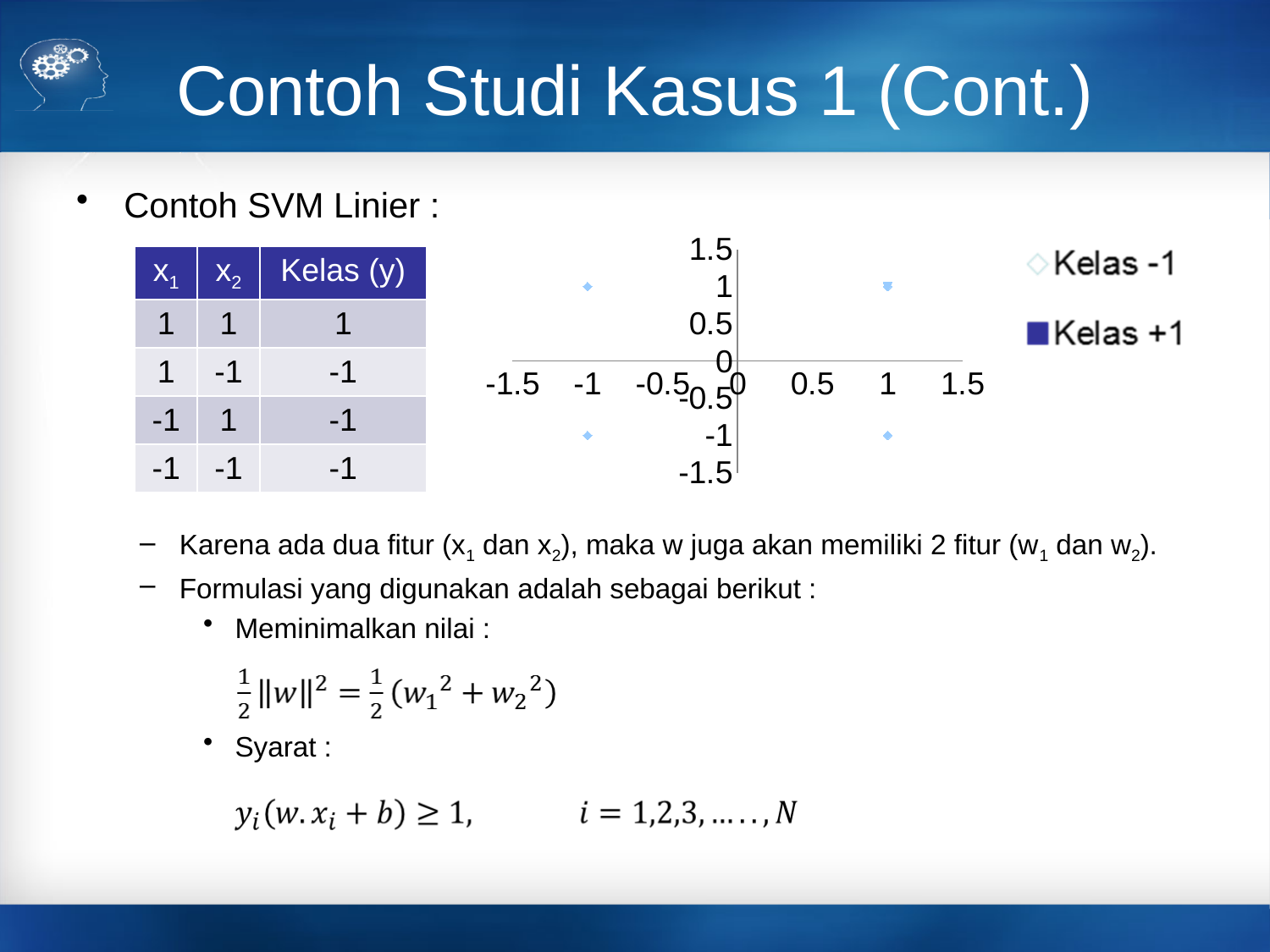
What are the two series named in the chart legend? Kelas -1 and Kelas +1 How many points belong to the Kelas +1 series? 1 How many data points are plotted on the chart? 4 What kind of chart is shown on the slide? scatter chart How many points belong to the Kelas -1 series? 3 What is the minimum value shown on the vertical axis of the chart? -1.5 What are the coordinates of the Kelas +1 point on the chart? (1, 1) Is the horizontal-axis value of the Kelas -1 point in the lower-left quadrant greater or less than -0.5? less What is the maximum value shown on the horizontal axis of the chart? 1.5 Is the vertical-axis value of the Kelas +1 point greater or less than 0.5? greater Which series has more points plotted, Kelas -1 or Kelas +1? Kelas -1 How many series does the chart legend list? 2